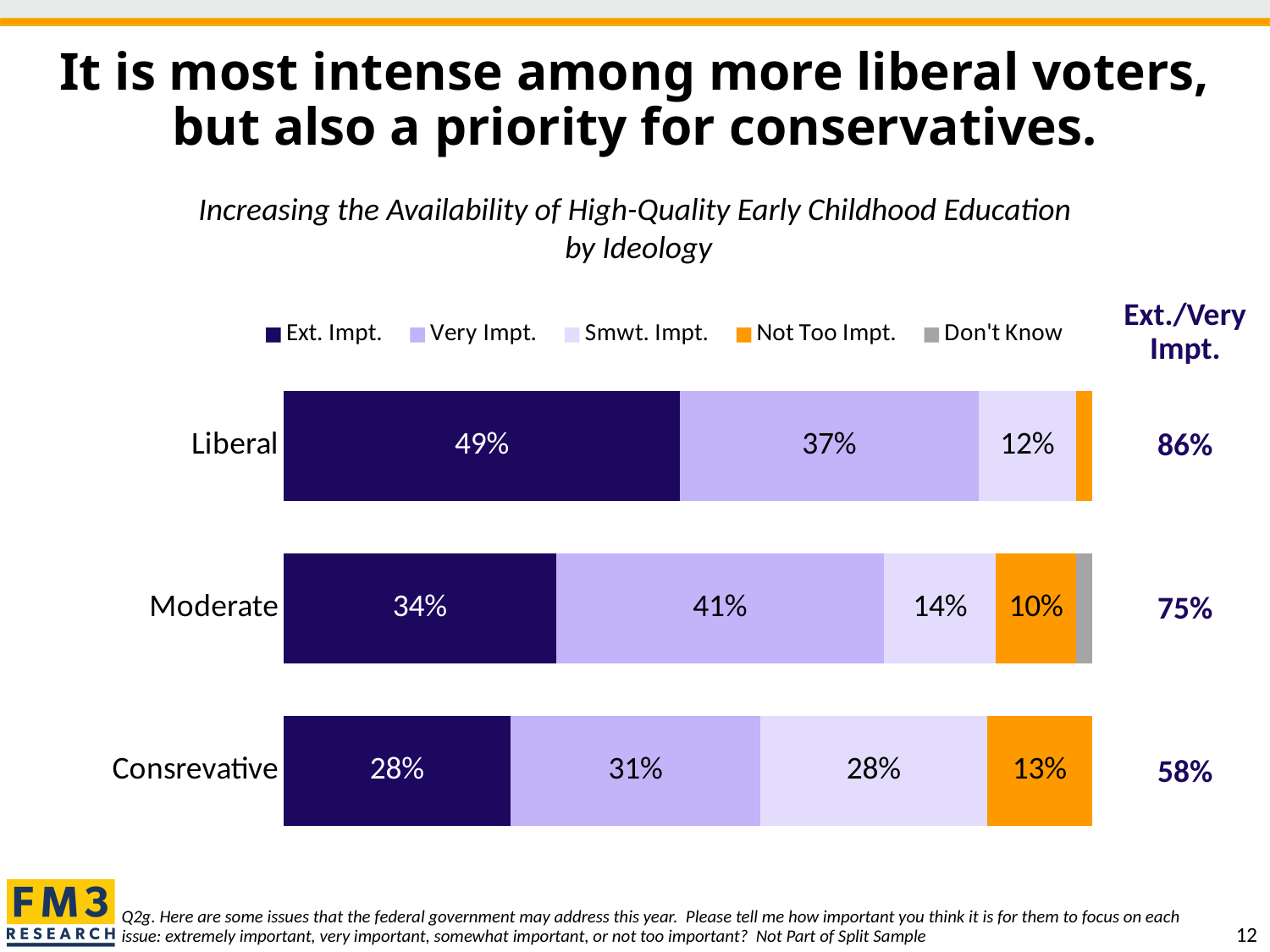
Which is larger: the Smwt. Impt. share for Conservative voters or for Moderate voters? Conservative How many ideology groups are shown in the chart? 3 Which ideology group has the highest Ext. Impt. share? Liberal What is the combined Ext./Very Impt. figure shown for Moderate voters? 75% Which ideology group has the lowest combined Ext./Very Impt. figure? Conservative What percentage of Liberal voters say the issue is extremely important (Ext. Impt.)? 49% What is the Not Too Impt. value for Conservative voters? 13% What type of chart is shown on the slide? Stacked bar chart How many series does the legend list? 5 How many percentage points higher is the Ext. Impt. share for Liberal voters than for Conservative voters? 21 percentage points What is the Very Impt. value for Moderate voters? 41% Which legend entry is shown in orange? Not Too Impt.